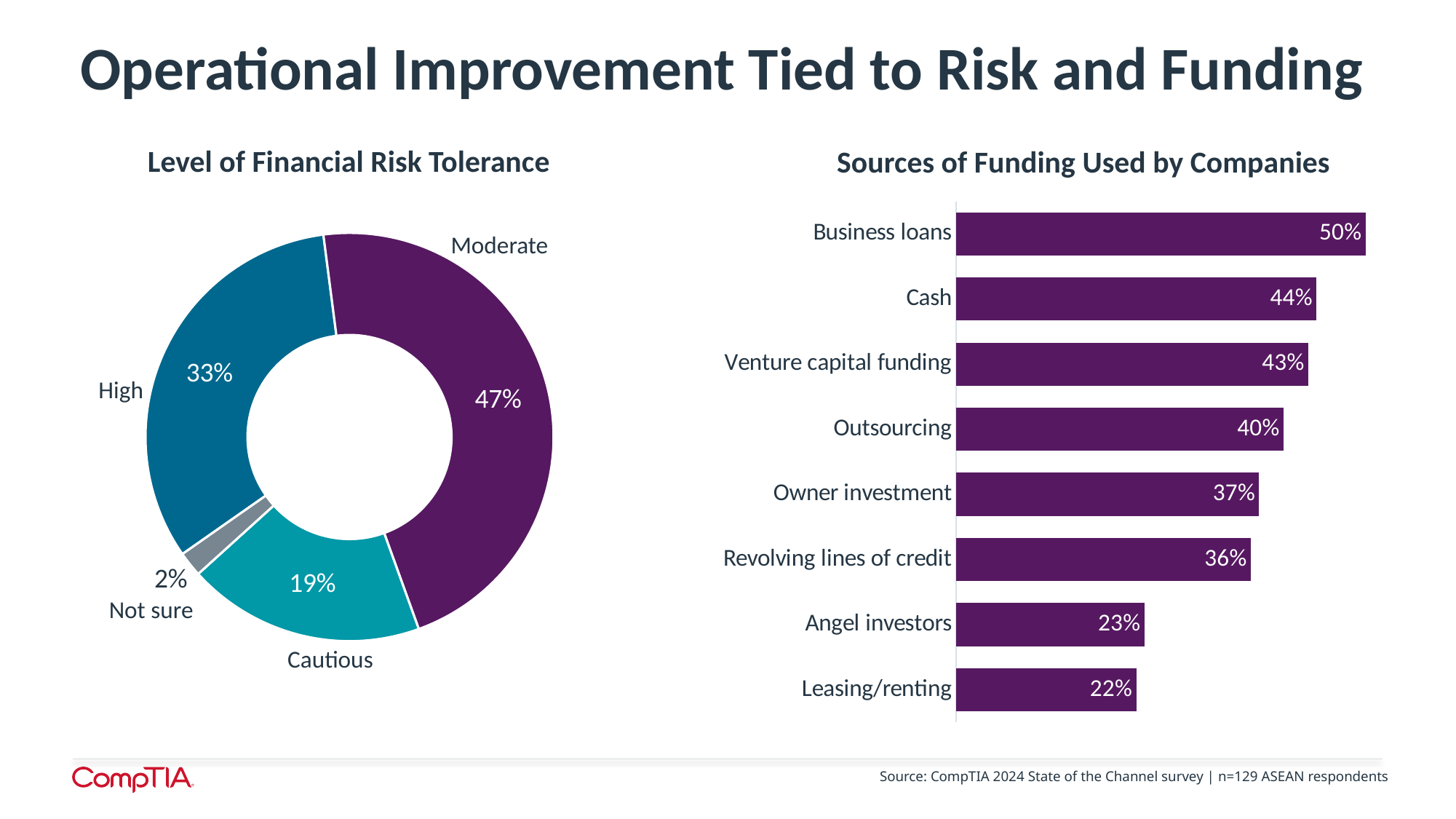
In the 'Level of Financial Risk Tolerance' chart, which category has the smallest share? Not sure In the 'Level of Financial Risk Tolerance' chart, what is the difference between the Moderate and Cautious shares? 28 percentage points In the 'Level of Financial Risk Tolerance' chart, how many categories are shown? 4 In the 'Sources of Funding Used by Companies' chart, how many funding sources are listed? 8 In the 'Sources of Funding Used by Companies' chart, what is the value for Outsourcing? 40% In the 'Level of Financial Risk Tolerance' chart, what percentage is shown for High? 33% What kind of chart is the 'Sources of Funding Used by Companies' chart? Bar chart In the 'Sources of Funding Used by Companies' chart, what is the difference between Cash and Angel investors? 21 percentage points In the 'Sources of Funding Used by Companies' chart, which funding source has the highest value? Business loans In the 'Sources of Funding Used by Companies' chart, which funding source has the lowest value? Leasing/renting In the 'Level of Financial Risk Tolerance' chart, what share of respondents reported a Moderate risk tolerance? 47% What kind of chart is the 'Level of Financial Risk Tolerance' chart? Pie chart (donut)